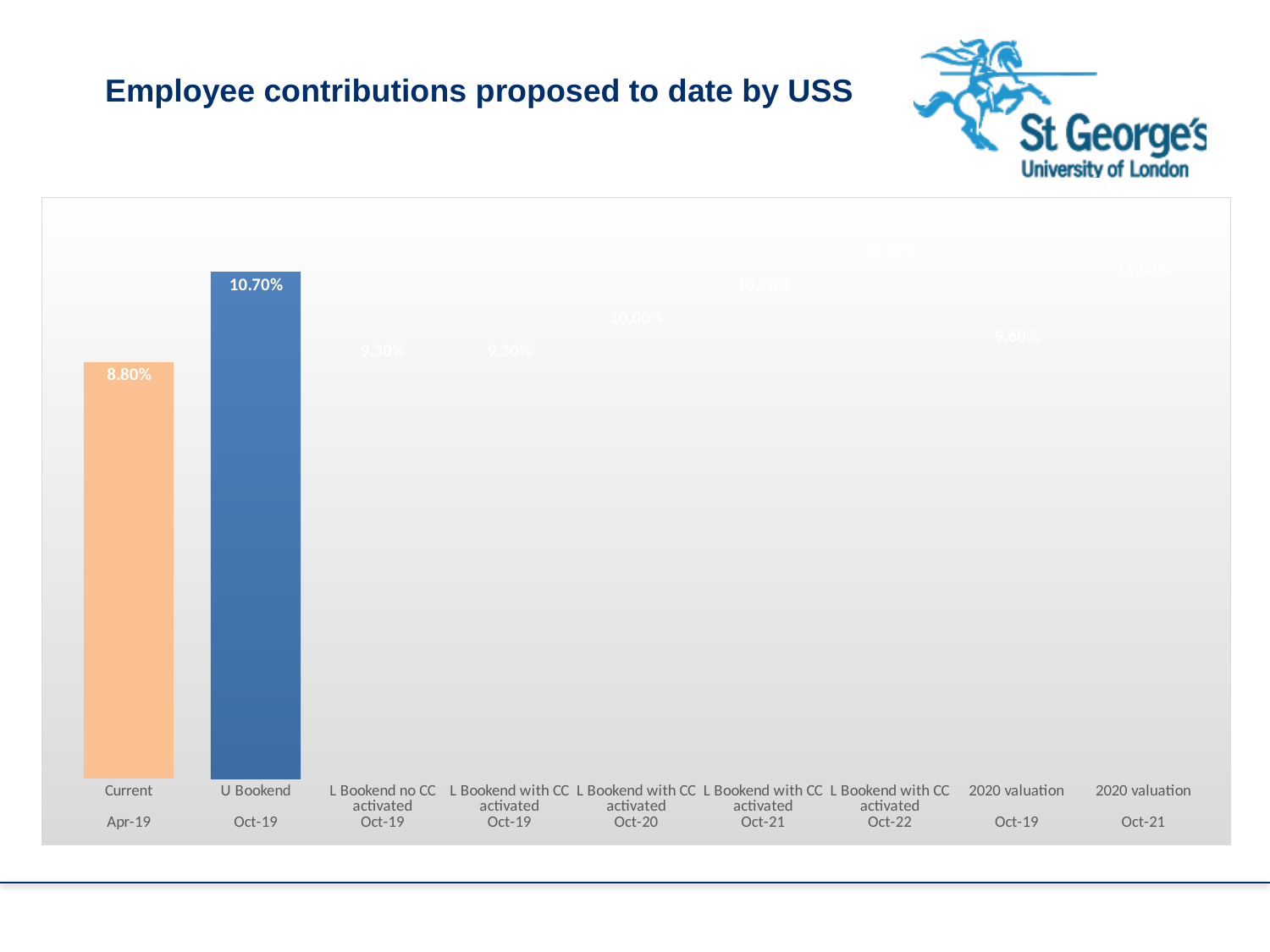
What is the value shown for the Current (Apr-19) bar? 8.80% How many categories are labelled along the x axis of the chart? 9 What colour is the bar for U Bookend (Oct-19)? Blue Which date label appears under the 'Current' category? Apr-19 What is the difference between the U Bookend (Oct-19) value and the Current (Apr-19) value? 1.90% Which date label appears under the last '2020 valuation' category on the right? Oct-21 What kind of chart is shown on the slide? Bar chart What is the title of the slide containing the chart? Employee contributions proposed to date by USS What is the value shown for the U Bookend (Oct-19) bar? 10.70% Which is larger, the Current (Apr-19) value or the U Bookend (Oct-19) value? U Bookend (Oct-19)